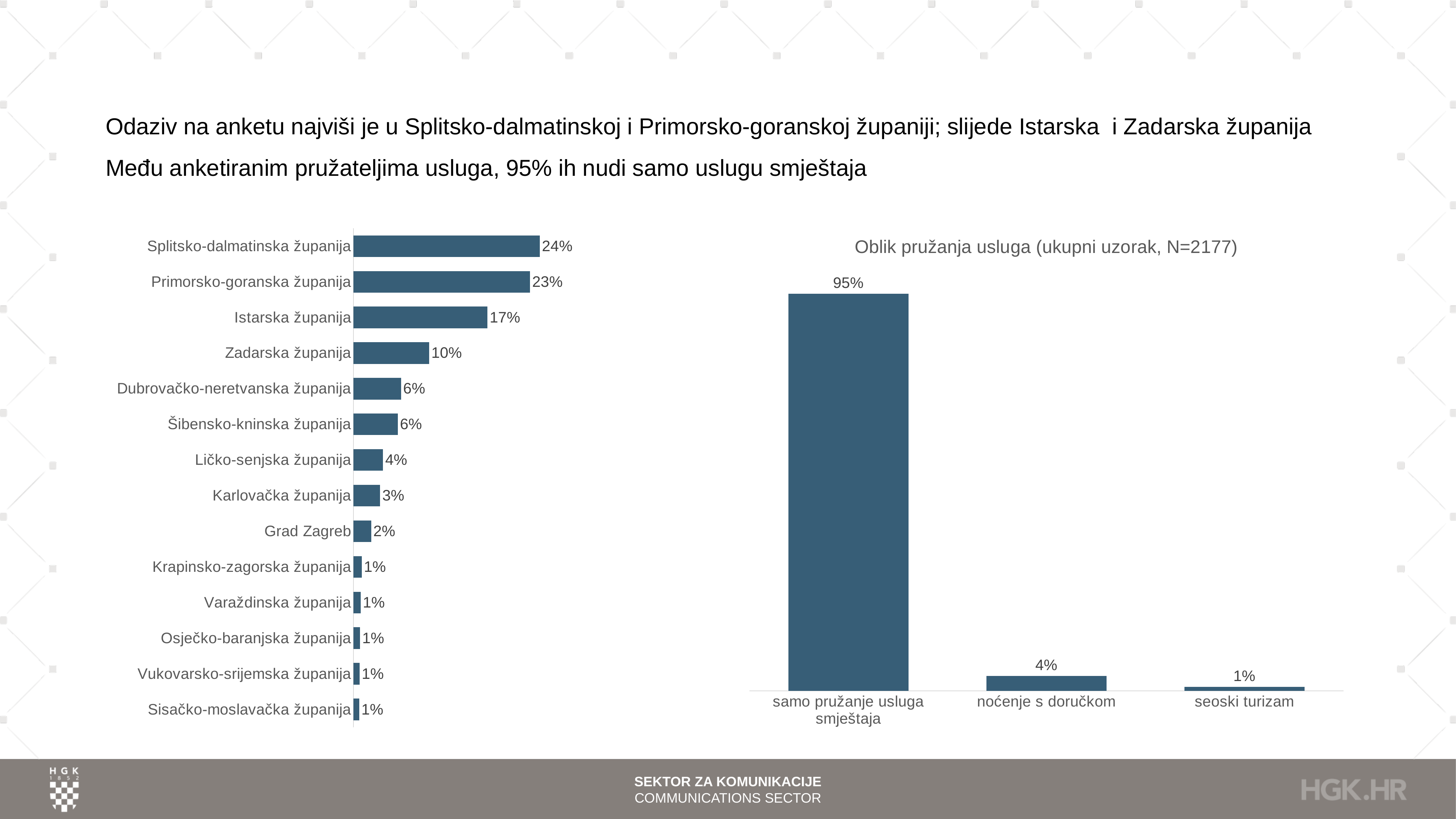
In the left-hand bar chart, what is the value for Zadarska županija? 10% In the chart titled 'Oblik pružanja usluga (ukupni uzorak, N=2177)', what is the value for 'noćenje s doručkom'? 4% In the chart titled 'Oblik pružanja usluga (ukupni uzorak, N=2177)', which category has the lowest value? seoski turizam How many categories are shown in the chart titled 'Oblik pružanja usluga (ukupni uzorak, N=2177)'? 3 How many counties are shown in the left-hand bar chart? 14 In the left-hand bar chart, what is the value for Grad Zagreb? 2% In the left-hand bar chart, which is larger, Ličko-senjska županija or Karlovačka županija? Ličko-senjska županija In the chart titled 'Oblik pružanja usluga (ukupni uzorak, N=2177)', what is the difference between 'samo pružanje usluga smještaja' and 'noćenje s doručkom'? 91% In the left-hand bar chart, what is the difference between Splitsko-dalmatinska županija and Primorsko-goranska županija? 1% In the left-hand bar chart, which county has the highest value? Splitsko-dalmatinska županija In the left-hand bar chart, what is the value for Istarska županija? 17% What type of chart is the chart titled 'Oblik pružanja usluga (ukupni uzorak, N=2177)'? Bar chart